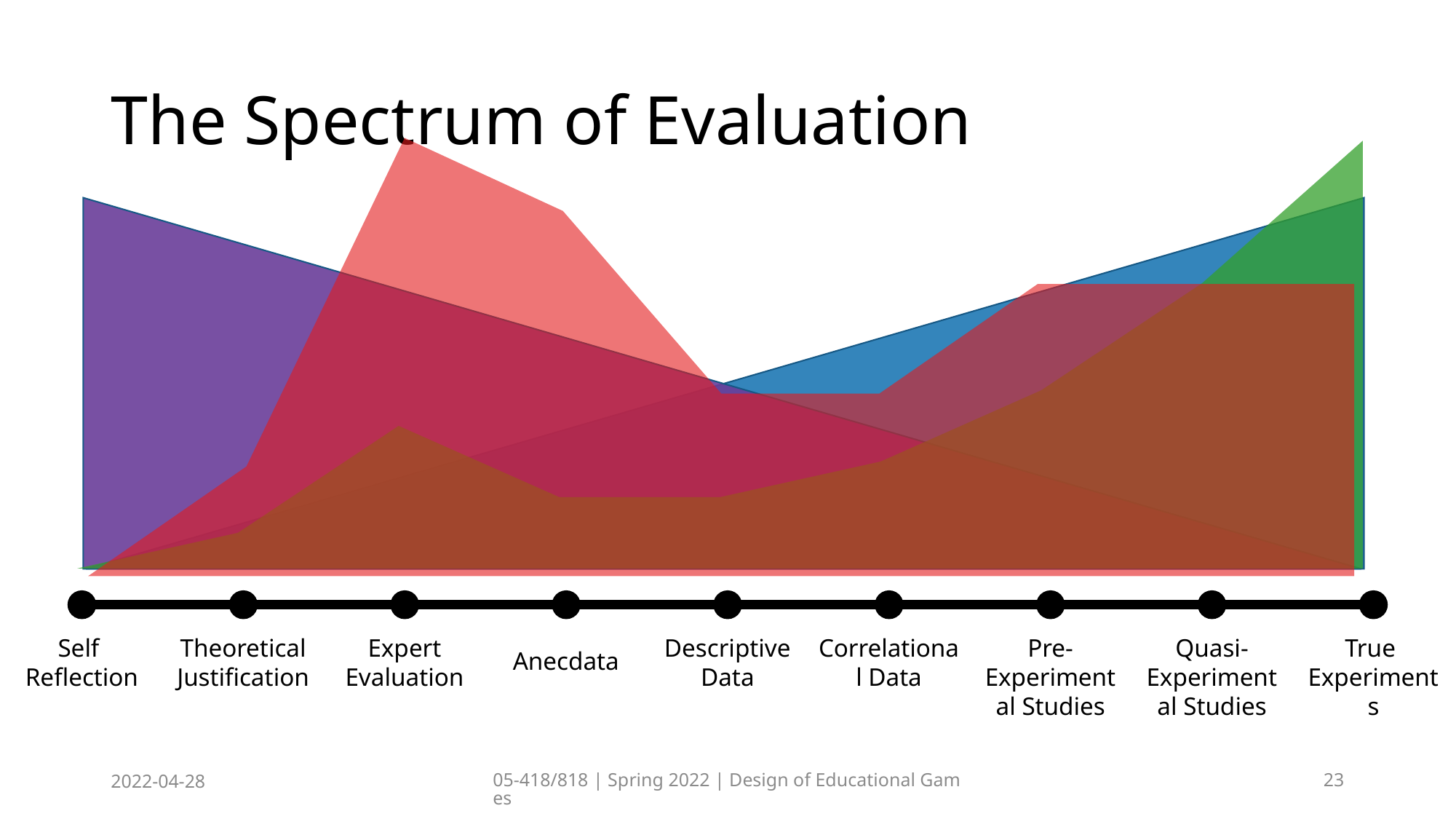
For the red series, which is larger: the value at Descriptive Data or the value at Pre-Experimental Studies? Pre-Experimental Studies What is the title of the slide containing the chart? The Spectrum of Evaluation How many categories are shown along the x axis of the chart? 9 At which category does the red series reach its highest value? Expert Evaluation At which category is the red series lowest? Self Reflection For the red series, which is larger: the value at Expert Evaluation or the value at Anecdata? Expert Evaluation At which category does the green series reach its highest value? True Experiments For the green series, which is larger: the value at True Experiments or the value at Quasi-Experimental Studies? True Experiments At which category is the green series lowest? Self Reflection Does the green series generally rise or fall from Correlational Data to True Experiments? rise What kind of chart is shown on the slide? area chart What is the label of the first category on the left of the x axis? Self Reflection